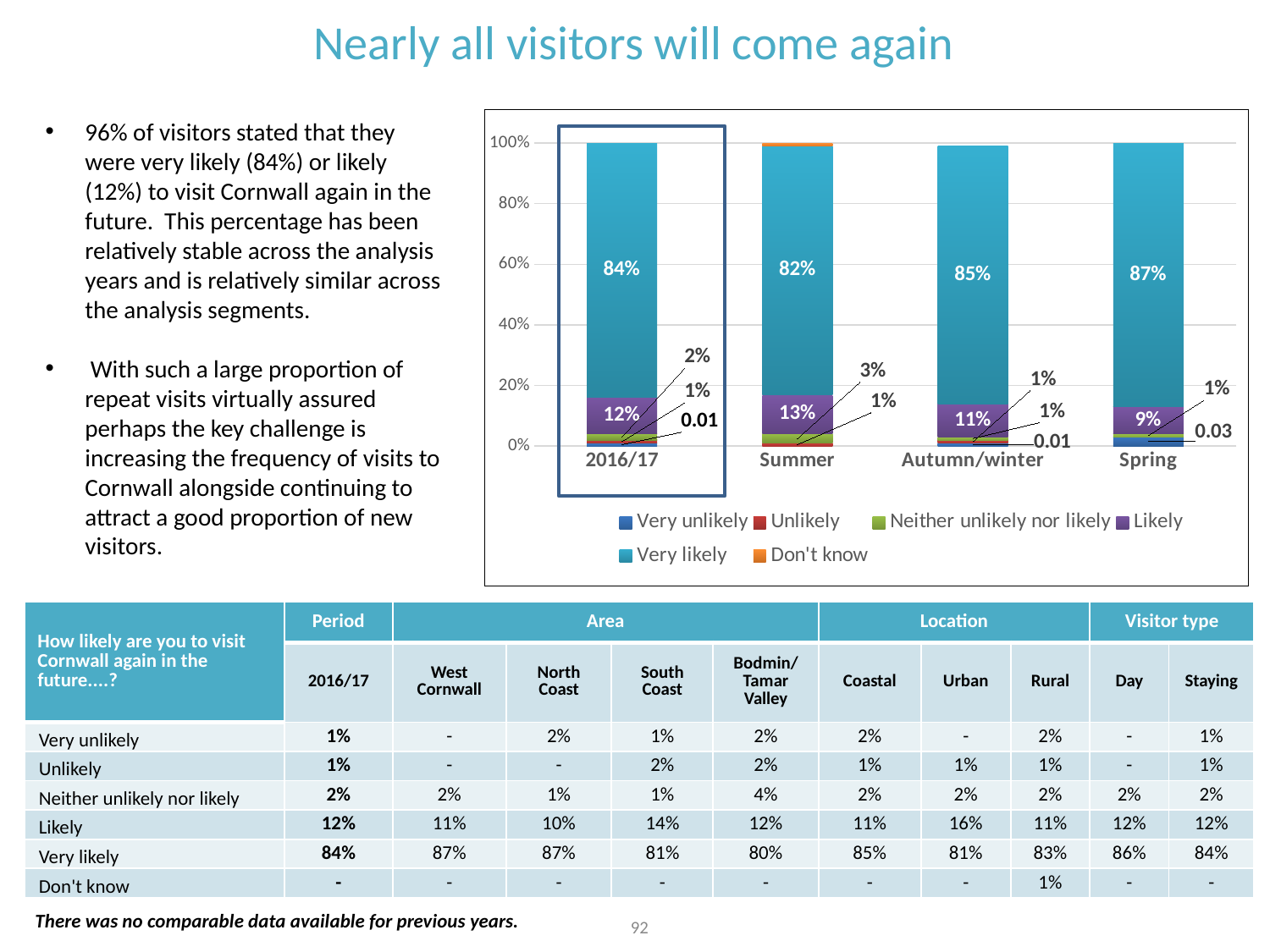
What is the value of the Very likely series for Spring? 87% Which category has the lowest Likely value? Spring How many categories are shown on the x axis of the chart? 4 What is the value of the Likely series for Summer? 13% Which has a larger Likely value, 2016/17 or Spring? 2016/17 What is the value of the Very likely series for 2016/17? 84% Which category has the highest Very likely value? Spring How many series does the chart legend list? 6 Is the Very likely value for Summer greater or less than 80%? greater What is the difference between the Very likely values for Spring and Summer? 5% What kind of chart is shown on the slide? Stacked bar chart What is the value of the Likely series for Autumn/winter? 11%